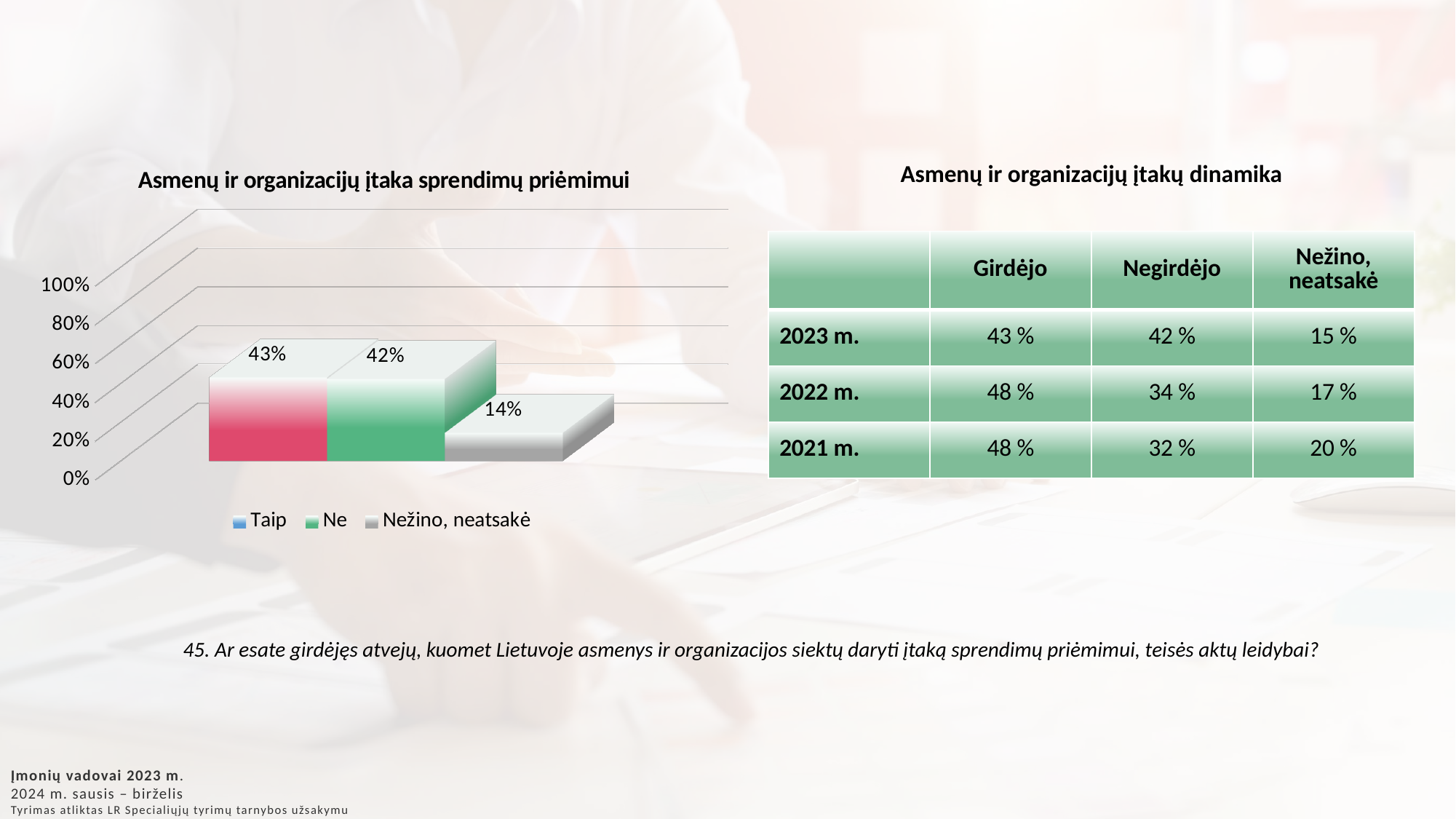
Which is larger, the value for Ne or the value for Nežino, neatsakė? Ne What kind of chart is shown on the slide? bar chart Which series has the highest value in the chart? Taip What is the value for Taip in the chart? 43% Which series has the lowest value in the chart? Nežino, neatsakė What is the difference between the values for Ne and Nežino, neatsakė? 28% What is the value for Ne in the chart? 42% What is the title of the chart? Asmenų ir organizacijų įtaka sprendimų priėmimui What is the value for Nežino, neatsakė in the chart? 14% How many series does the chart legend list? 3 What is the difference between the values for Taip and Nežino, neatsakė? 29% Is the value for Nežino, neatsakė greater or less than 20%? less